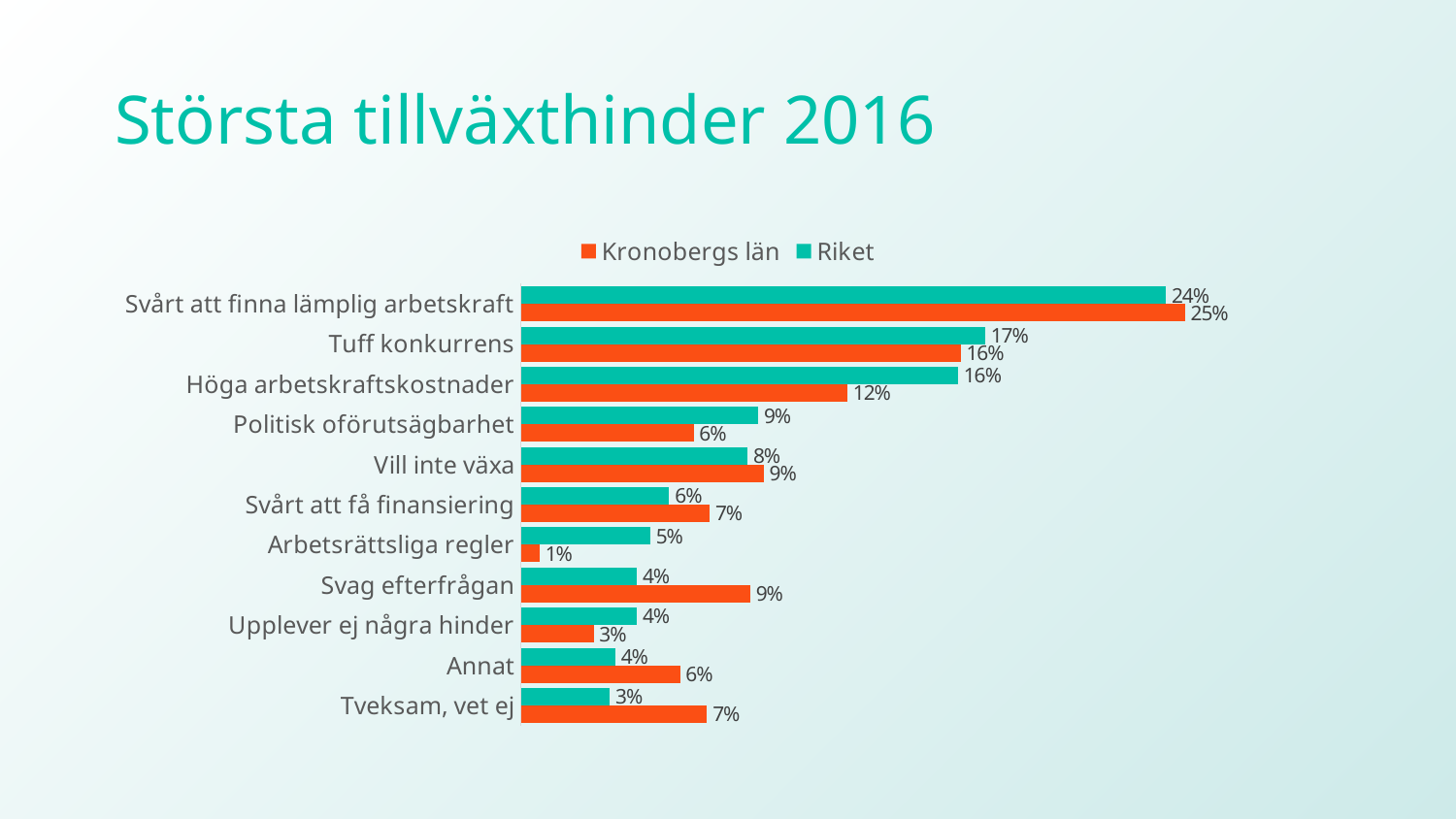
Which category has the highest value for Kronobergs län? Svårt att finna lämplig arbetskraft How many categories are shown in the chart? 11 What is the value for Riket for "Tveksam, vet ej"? 3% Which category has the lowest value for Kronobergs län? Arbetsrättsliga regler What is the difference between the Riket and Kronobergs län values for "Höga arbetskraftskostnader"? 4% What is the value for Kronobergs län for "Arbetsrättsliga regler"? 1% What type of chart is shown on the slide? Bar chart For "Svag efterfrågan", which series has the larger value, Kronobergs län or Riket? Kronobergs län How many series does the legend list? 2 What is the value for Kronobergs län for "Svårt att finna lämplig arbetskraft"? 25% What is the value for Riket for "Höga arbetskraftskostnader"? 16% What is the title of the slide? Största tillväxthinder 2016